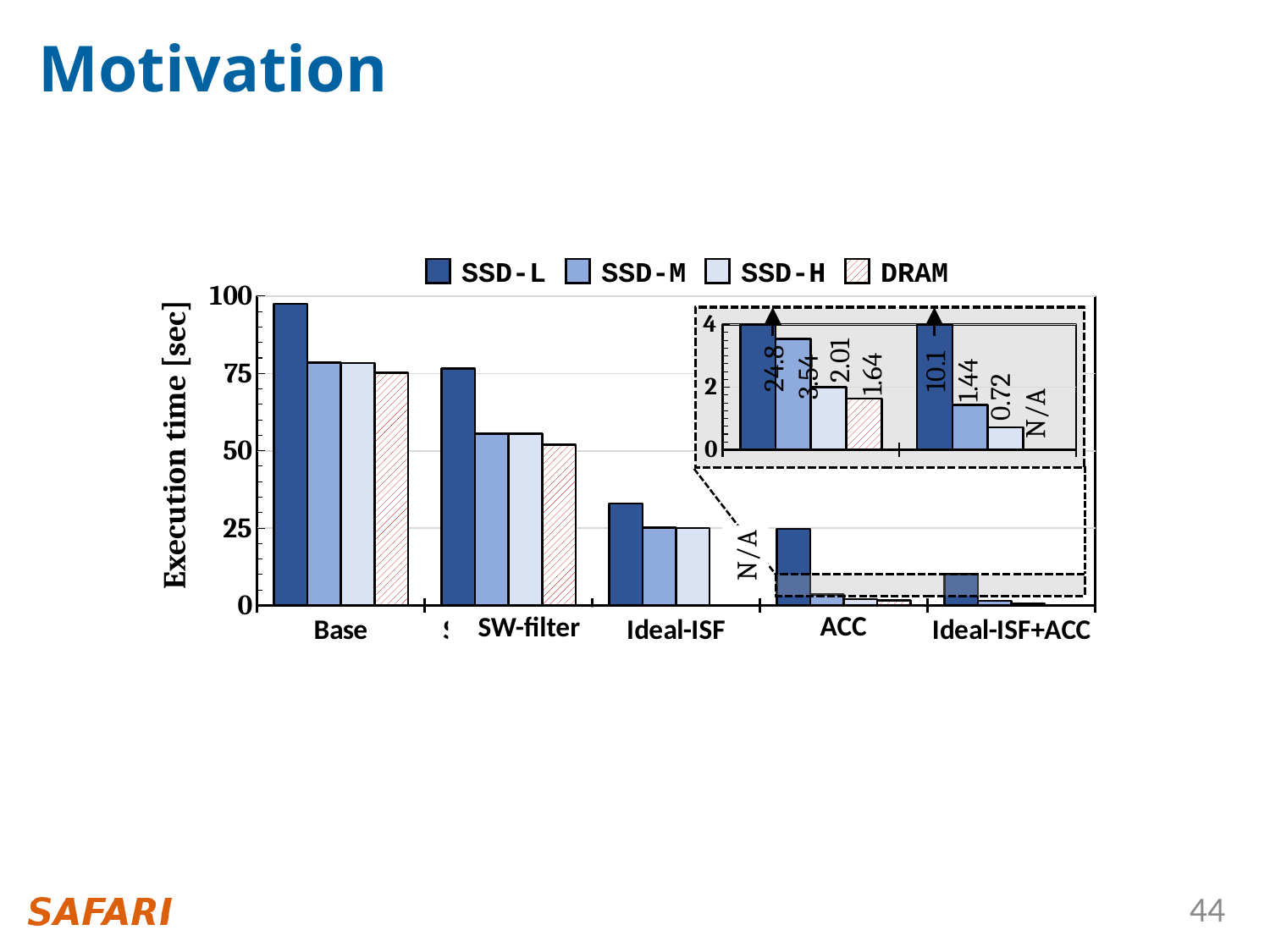
What value is shown for DRAM in the Ideal-ISF+ACC configuration? N/A What is the execution time for DRAM in the ACC configuration? 1.64 What is the execution time for SSD-H in the Ideal-ISF+ACC configuration? 0.72 Is the SSD-L execution time for Base greater or less than 75 seconds? greater How many series does the legend list? 4 What is the difference between the SSD-M and SSD-H execution times in the ACC configuration? 1.53 What is the execution time for SSD-L in the ACC configuration, as labelled in the inset? 24.8 Which configuration has the highest SSD-L execution time? Base How many configurations are shown on the x axis? 5 What is the difference between the SSD-L execution times for ACC (24.8) and Ideal-ISF+ACC (10.1)? 14.7 Does the SSD-L execution time rise or fall from Base to Ideal-ISF+ACC along the x axis? fall Is the SSD-M execution time for SW-filter greater or less than 75 seconds? less